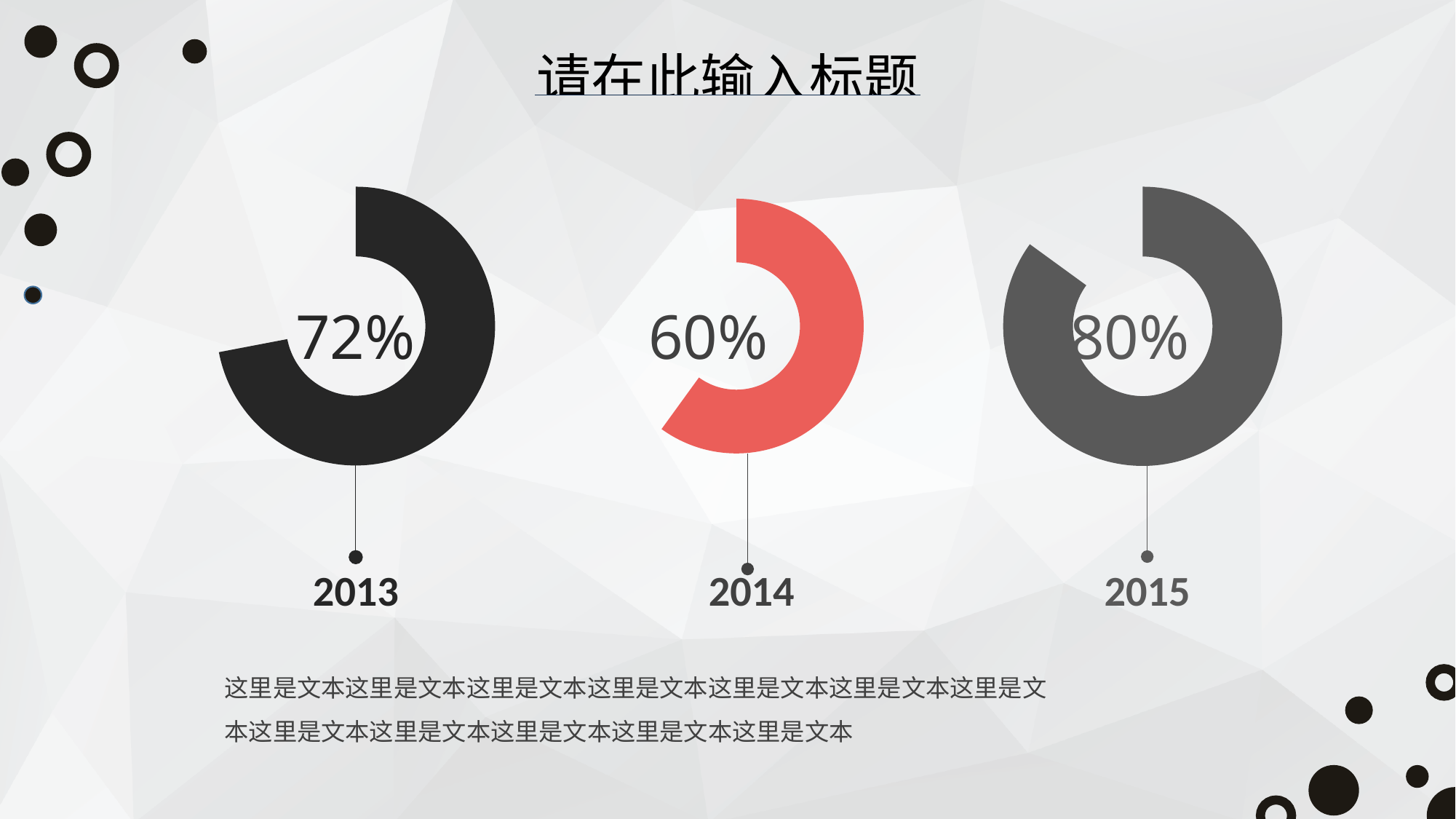
Which year label appears under the leftmost donut chart? 2013 Which of the three donut charts is drawn in red? 2014 Across the three donut charts (2013, 2014, 2015), which year shows the lowest percentage? 2014 Across the three donut charts (2013, 2014, 2015), which year shows the highest percentage? 2015 What is the difference between the percentage in the 2015 donut chart and the percentage in the 2014 donut chart? 20% What kind of chart is used for the 2014 value on the slide? Donut (pie) chart What value is shown in the donut chart labelled 2015? 80% Which is larger, the percentage in the 2013 donut chart or the percentage in the 2015 donut chart? 2015 What value is shown in the donut chart labelled 2013? 72% What value is shown in the donut chart labelled 2014? 60% How many donut charts are shown on the slide? 3 What is the difference between the percentage in the 2013 donut chart and the percentage in the 2014 donut chart? 12%